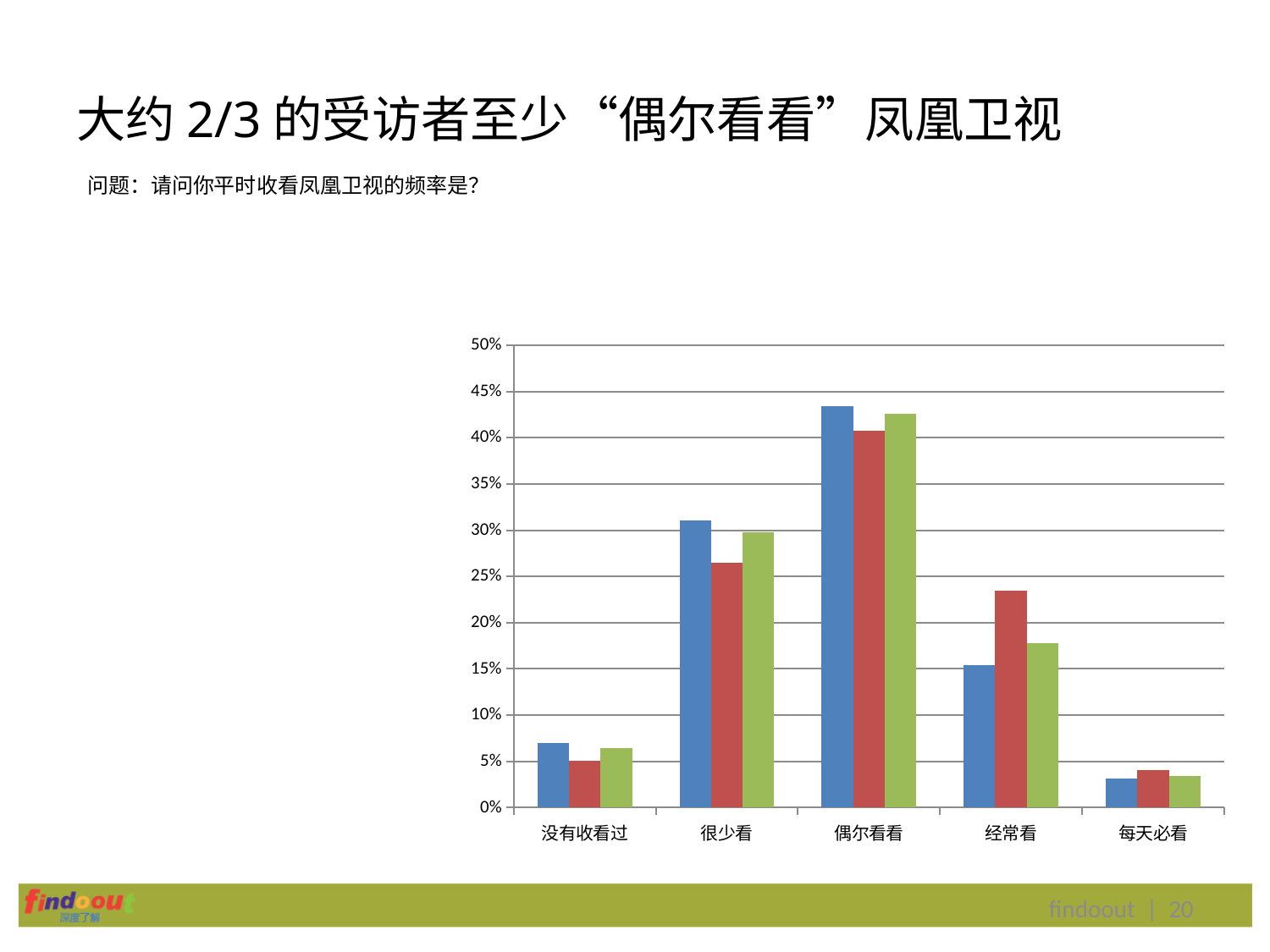
Which category has the highest bars in the chart? 偶尔看看 For the category 很少看, which bar is taller, the blue bar or the red bar? the blue bar Is the value of the green bar for 经常看 greater or less than 20%? less Is the value of the blue bar for 没有收看过 greater or less than 5%? greater Which category has the lowest bars in the chart? 每天必看 What kind of chart is shown on the slide? bar chart Is the value of the red bar for 经常看 greater or less than 20%? greater How many bars are plotted for each category in the chart? 3 How many categories are shown on the x axis of the chart? 5 For the category 经常看, which bar is taller, the blue bar or the red bar? the red bar What is the highest value shown on the chart's vertical axis? 50%